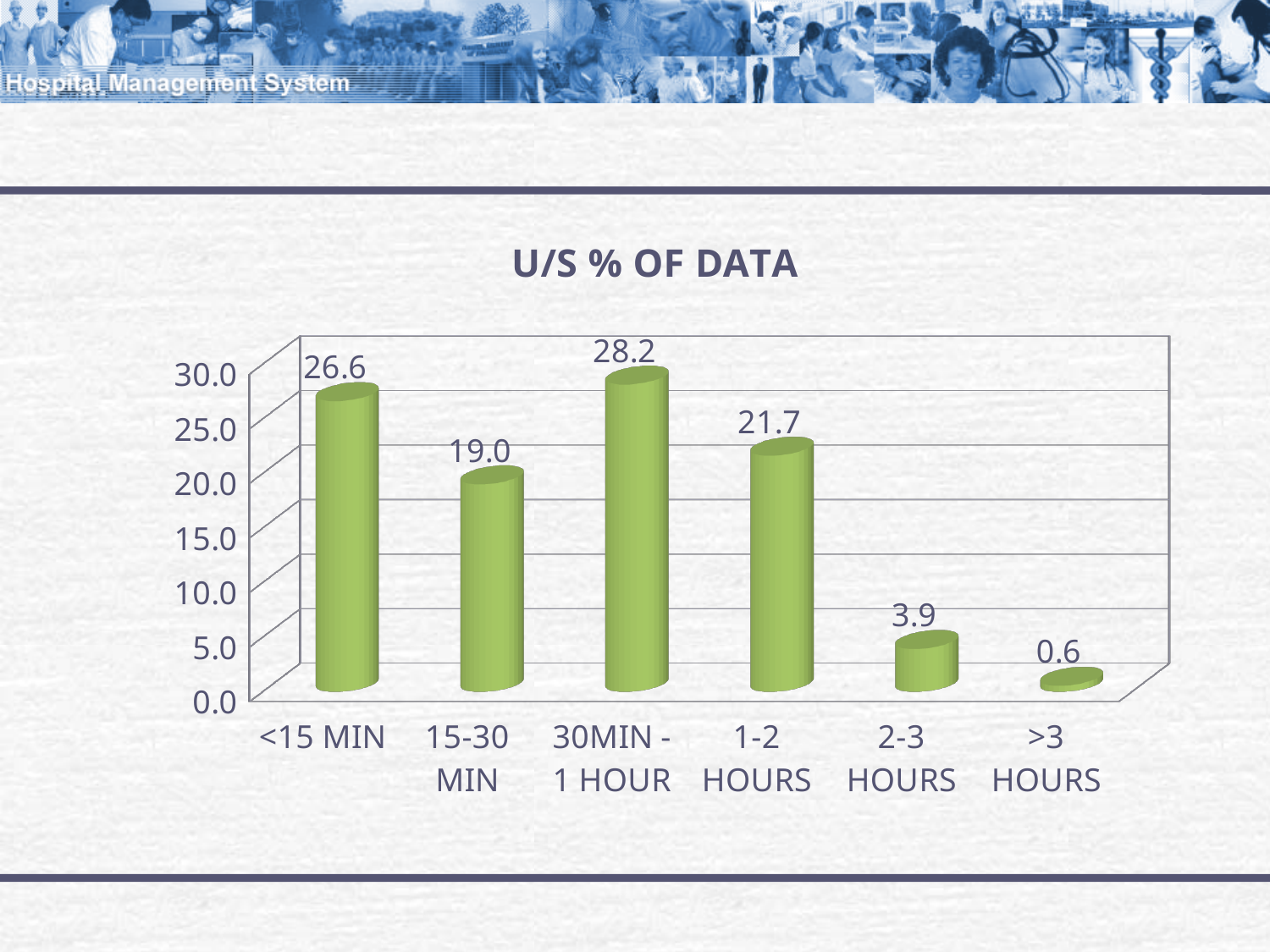
Which category has the lowest value? >3 HOURS What is the value for <15 MIN? 26.6 What is the value for >3 HOURS? 0.6 What is the difference between the values for 30MIN - 1 HOUR and 1-2 HOURS? 6.5 How many categories are shown on the x axis? 6 Which is larger, the value for <15 MIN or the value for 15-30 MIN? <15 MIN What is the value for 30MIN - 1 HOUR? 28.2 What is the value for 15-30 MIN? 19.0 What kind of chart is this? bar chart Is the value for 2-3 HOURS greater or less than 5.0? less What is the title of the chart? U/S % OF DATA Which category has the highest value? 30MIN - 1 HOUR